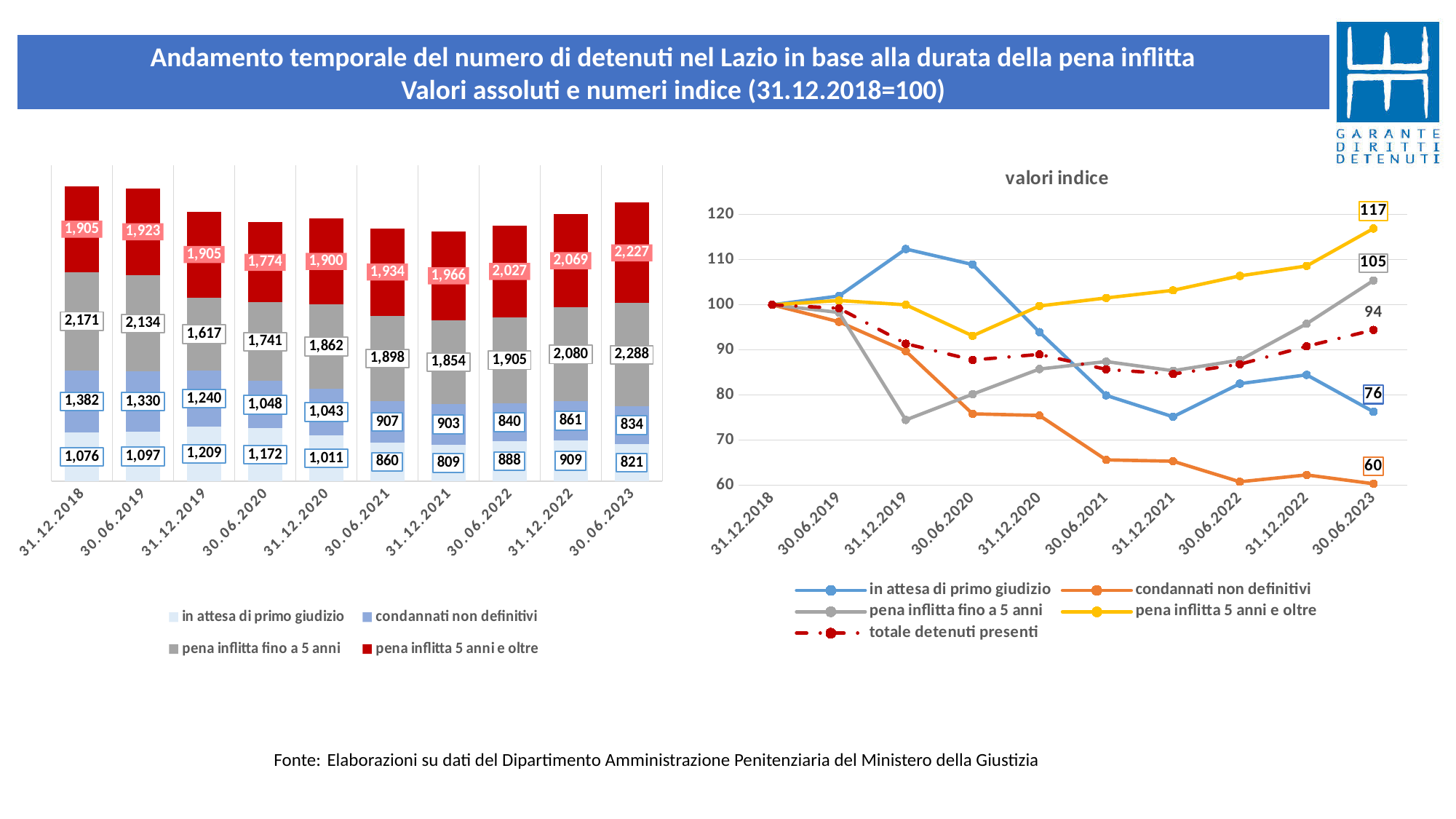
In the stacked bar chart on the left, at which date is the 'pena inflitta fino a 5 anni' segment highest? 30.06.2023 In the stacked bar chart on the left, what is the value for 'pena inflitta 5 anni e oltre' at 30.06.2023? 2,227 In the stacked bar chart on the left, what is the value for 'pena inflitta fino a 5 anni' at 30.06.2021? 1,898 In the 'valori indice' chart, what is the value labelled for 'pena inflitta 5 anni e oltre' at 30.06.2023? 117 In the 'valori indice' chart, is the value for 'in attesa di primo giudizio' at 31.12.2019 greater or less than 110? greater In the stacked bar chart on the left, what is the value for 'in attesa di primo giudizio' at 31.12.2019? 1,209 In the 'valori indice' chart, what is the value labelled for 'condannati non definitivi' at 30.06.2023? 60 In the 'valori indice' chart, how many series does the legend list? 5 In the stacked bar chart on the left, at which date is the 'in attesa di primo giudizio' segment lowest? 31.12.2021 In the stacked bar chart on the left, what is the difference between the 'condannati non definitivi' values at 31.12.2018 and 30.06.2023? 548 In the stacked bar chart on the left, what is the total of the bar for 31.12.2018? 6,534 In the stacked bar chart on the left, how many dates are shown on the x axis? 10